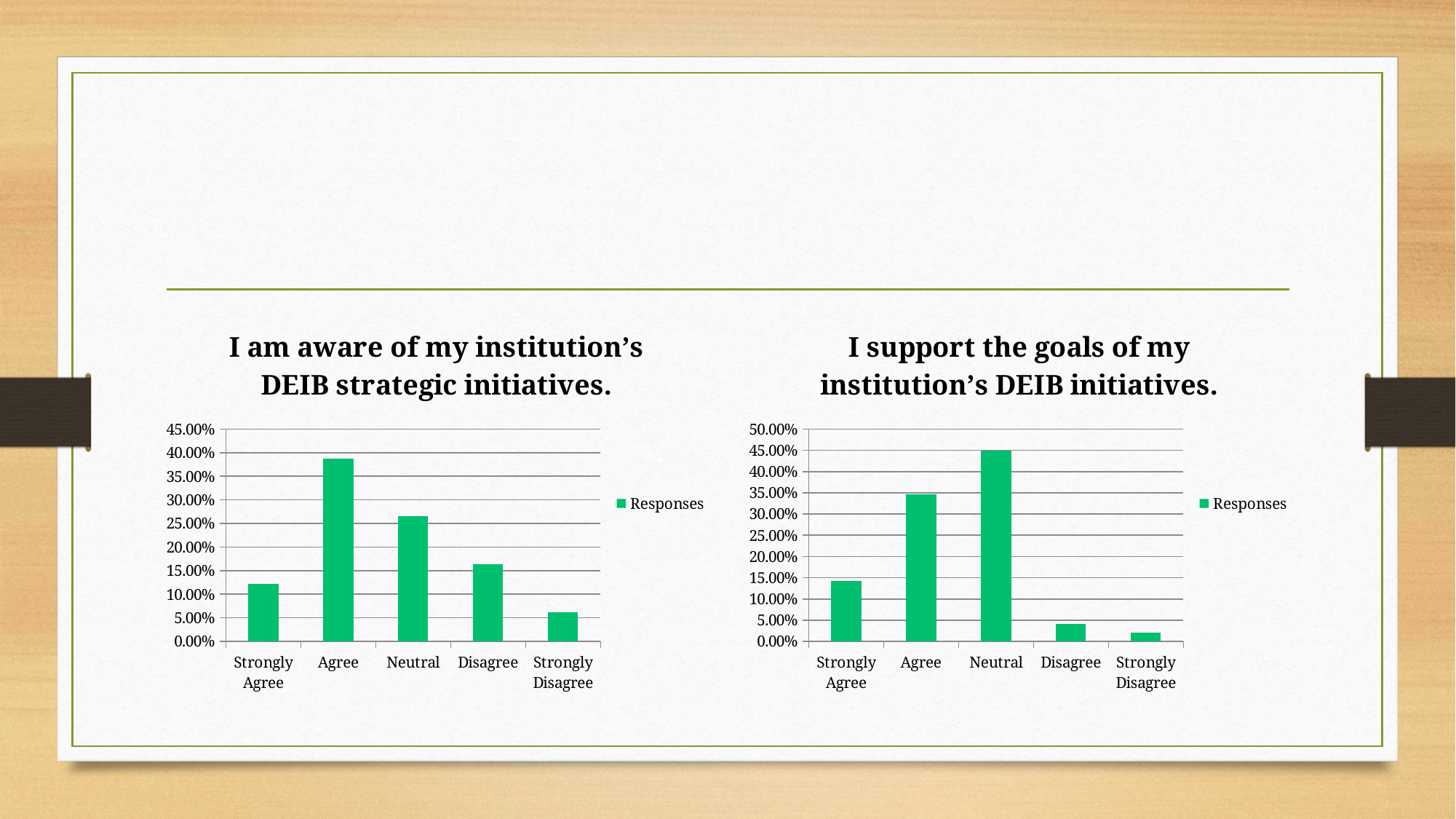
What type of chart is the left chart? Bar chart In the chart titled "I am aware of my institution's DEIB strategic initiatives.", which category has the lowest value? Strongly Disagree In the left chart, is the value for Strongly Disagree greater or less than 10.00%? less How many categories are shown on the x axis of the right chart? 5 In the left chart, is the value for Agree greater or less than 35.00%? greater In the right chart, is the value for Agree greater or less than 30.00%? greater In the chart titled "I support the goals of my institution's DEIB initiatives.", which category has the lowest value? Strongly Disagree In the left chart, which is larger, the value for Neutral or the value for Disagree? Neutral In the right chart, which is larger, the value for Strongly Agree or the value for Disagree? Strongly Agree In the chart titled "I support the goals of my institution's DEIB initiatives.", which category has the highest value? Neutral In the chart titled "I am aware of my institution's DEIB strategic initiatives.", which category has the highest value? Agree